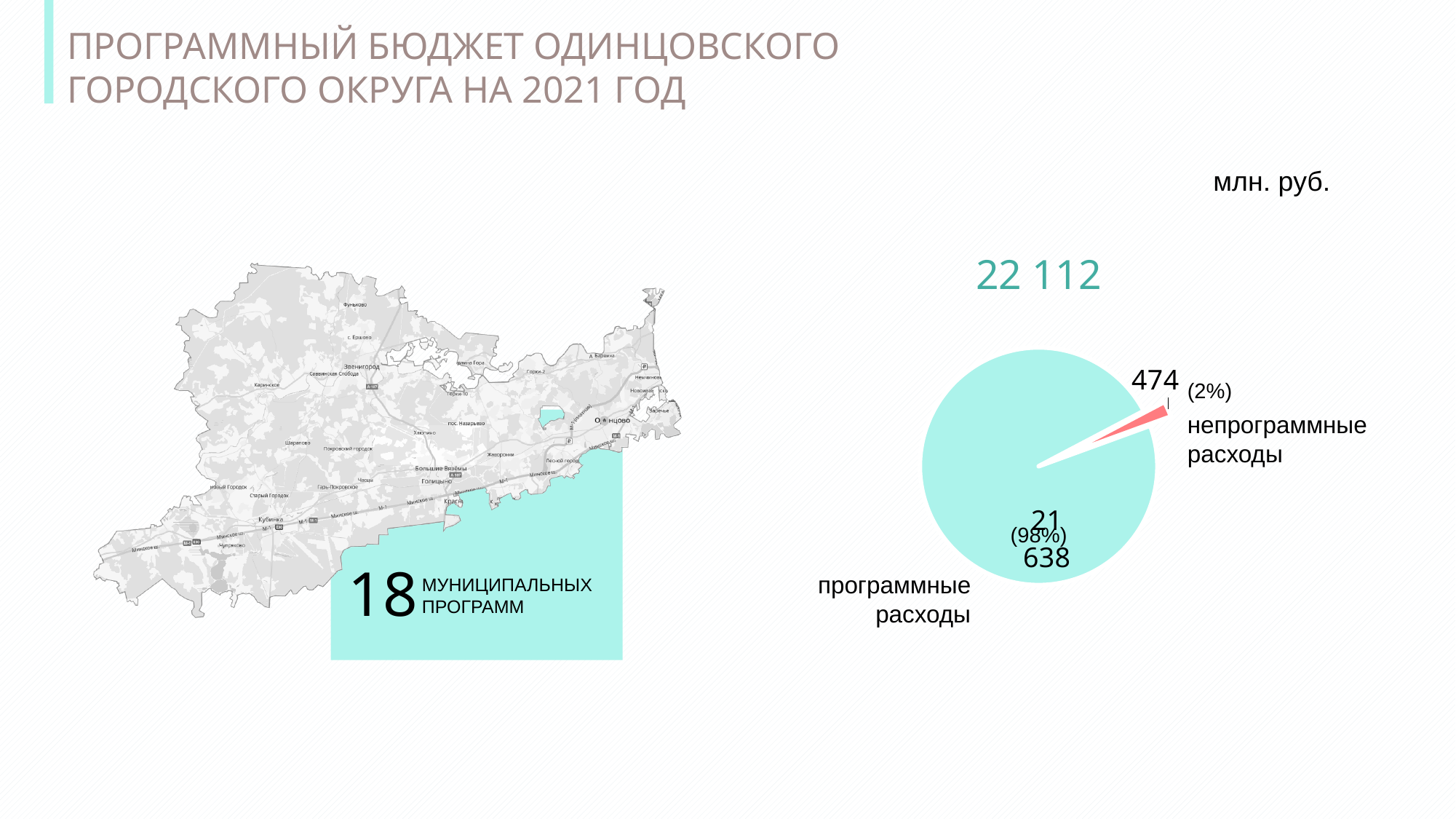
What share of the pie do программные расходы make up? 98% What unit is indicated for the values in the pie chart? млн. руб. Which slice of the pie chart is the largest? программные расходы What colour is the slice for непрограммные расходы in the pie chart? red Which is larger in the pie chart, программные расходы or непрограммные расходы? программные расходы How many slices does the pie chart have? 2 What is the total value shown above the pie chart? 22 112 What kind of chart is shown on the right side of the slide? pie chart What is the value for непрограммные расходы in the pie chart? 474 What share of the pie do непрограммные расходы make up? 2% What is the value for программные расходы in the pie chart? 21 638 Which slice of the pie chart is the smallest? непрограммные расходы